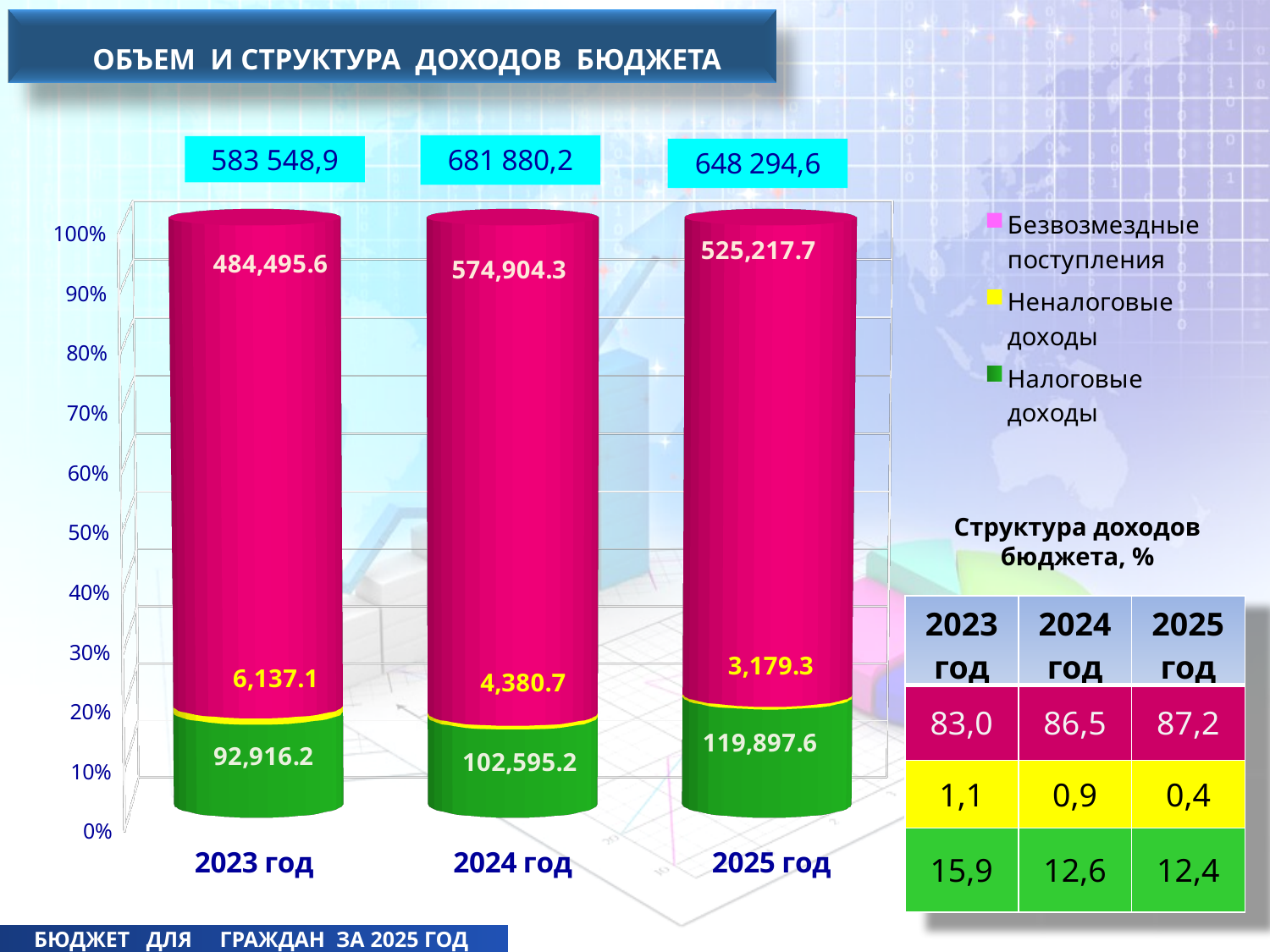
What kind of chart is shown on the slide? Stacked bar chart How many series does the legend list? 3 What is the value of Налоговые доходы for 2023 год? 92,916.2 What is the value of Безвозмездные поступления for 2024 год? 574,904.3 What is the value of Налоговые доходы for 2025 год? 119,897.6 What is the value of Неналоговые доходы for 2025 год? 3,179.3 Which year has the lowest value for Неналоговые доходы? 2025 год Which colour represents Неналоговые доходы in the chart? Yellow How many years (categories) are shown on the chart? 3 What is the difference between Налоговые доходы for 2025 год and 2024 год? 17,302.4 Which is larger: Безвозмездные поступления for 2024 год or for 2025 год? 2024 год Which year has the highest value for Налоговые доходы? 2025 год